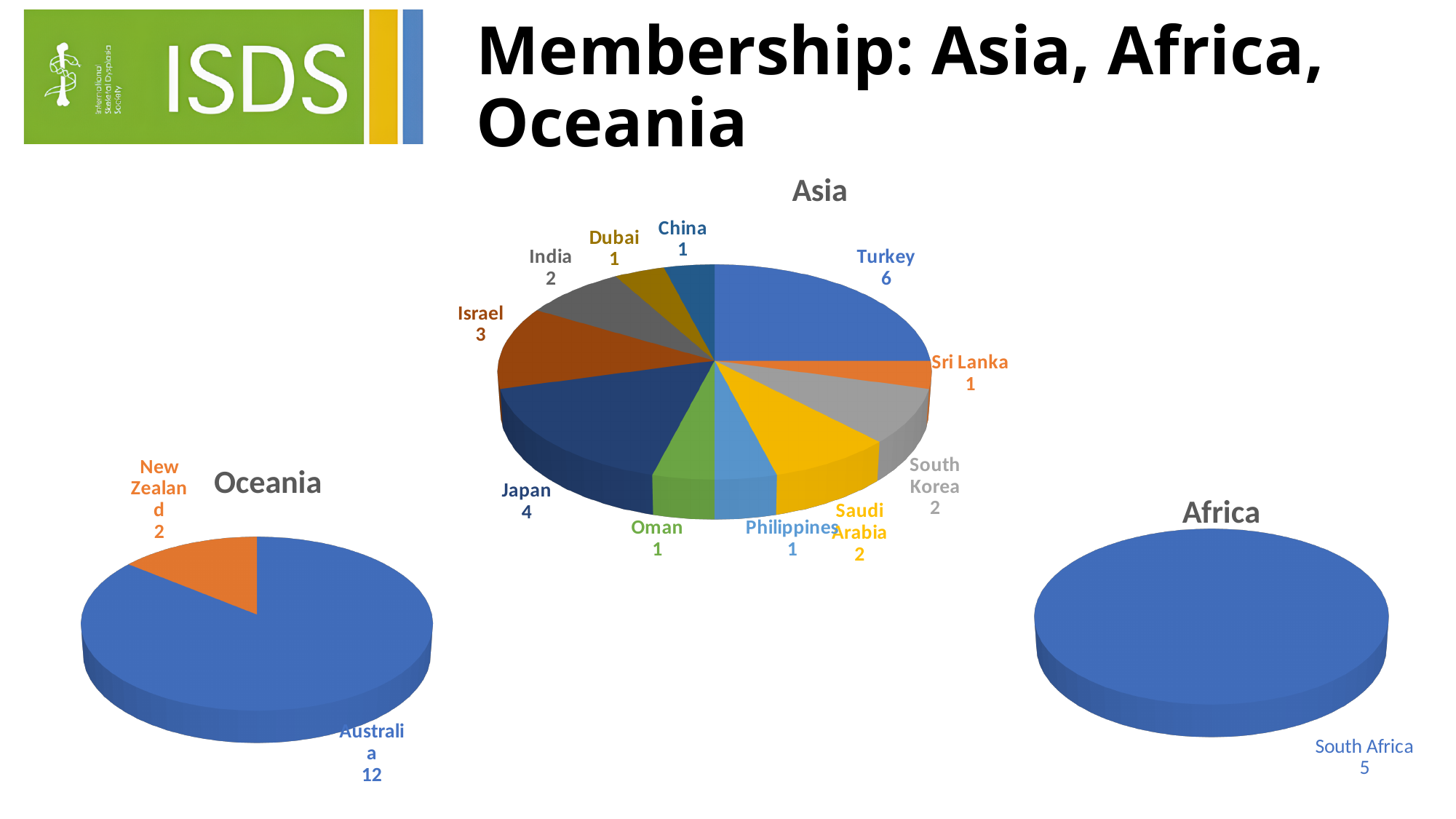
In the Asia chart, which is larger, Japan or India? Japan In the Oceania chart, what is the difference between Australia and New Zealand? 10 In the Asia chart, which country has the largest slice? Turkey In the Oceania chart, what is the value for Australia? 12 In the Asia chart, what share of the total does Turkey represent? 25% How many charts are on the slide? 3 In the Asia chart, how many members does Turkey have? 6 In the Asia chart, what is the difference between Turkey and Israel? 3 In the Africa chart, how many members does South Africa have? 5 How many countries are shown in the Asia chart? 11 In the Asia chart, what is the value for Japan? 4 What type of chart is used for Oceania? Pie chart